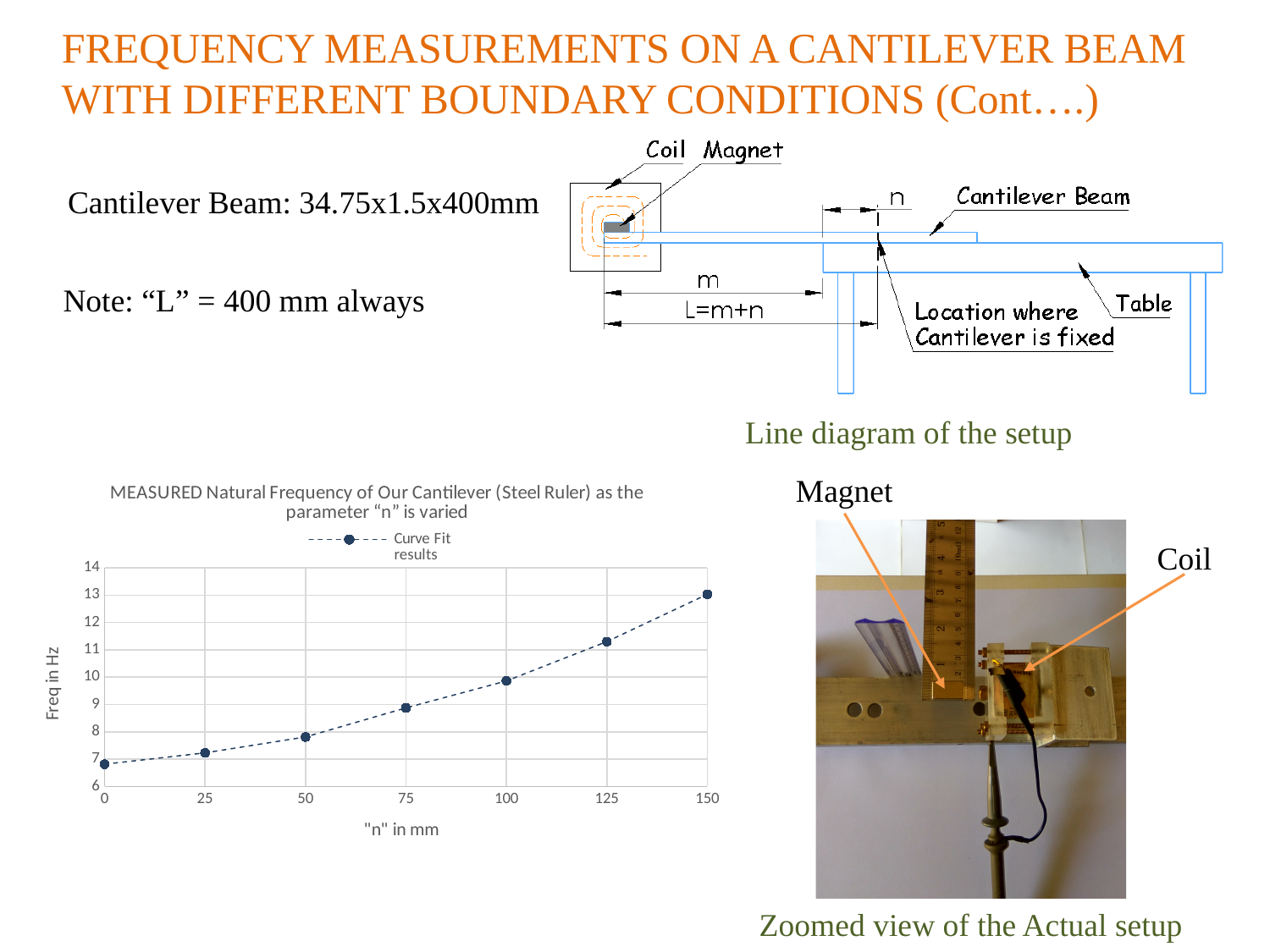
How many data points are plotted on the chart? 7 Does the measured natural frequency rise or fall as "n" increases along the x axis? rise At which value of "n" is the measured frequency lowest? 0 What series name appears in the chart legend? Curve Fit results Is the frequency at n = 150 mm greater or less than 12 Hz? greater Which has the higher frequency: n = 100 mm or n = 50 mm? n = 100 mm Is the frequency at n = 0 mm greater or less than 7 Hz? less What kind of chart is shown on the slide? line chart What is the label of the chart's y axis? Freq in Hz At which value of "n" is the measured frequency highest? 150 How many series does the chart legend list? 1 Is the frequency at n = 125 mm greater or less than 11 Hz? greater